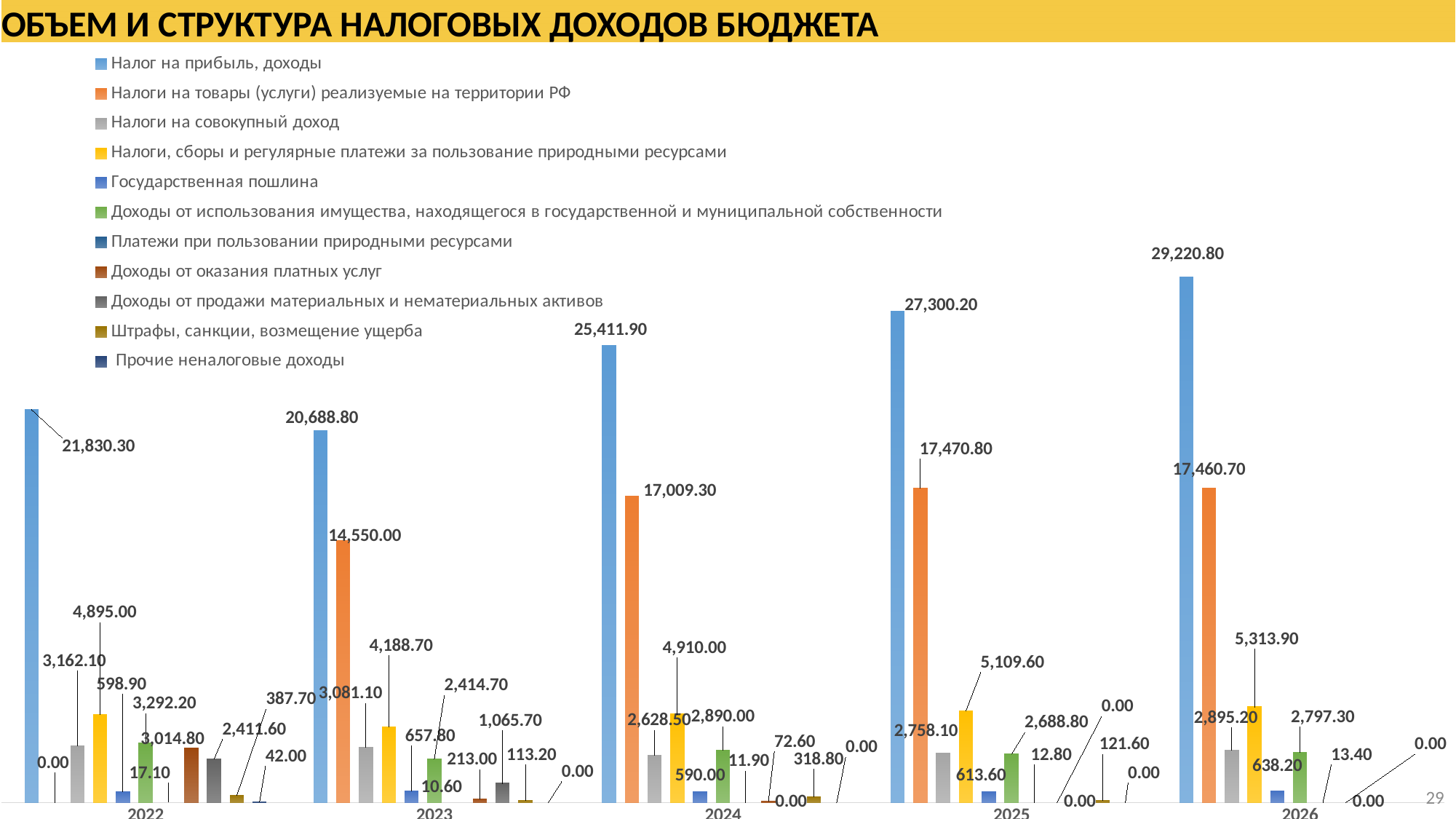
What is the value of 'Налоги, сборы и регулярные платежи за пользование природными ресурсами' for 2025? 5,109.60 What is the value of 'Налоги на товары (услуги) реализуемые на территории РФ' for 2024? 17,009.30 How many years are shown on the x axis? 5 What kind of chart is shown on the slide? Bar chart What is the value of 'Налог на прибыль, доходы' for 2022? 21,830.30 Which is larger: 'Налог на прибыль, доходы' in 2024 or in 2023? 2024 What is the title of the slide? ОБЪЕМ И СТРУКТУРА НАЛОГОВЫХ ДОХОДОВ БЮДЖЕТА In which year is 'Налог на прибыль, доходы' highest? 2026 In which year is 'Налог на прибыль, доходы' lowest? 2023 What is the value of 'Налог на прибыль, доходы' for 2026? 29,220.80 How many series does the legend list? 11 What is the difference between 'Налог на прибыль, доходы' in 2026 and in 2025? 1,920.60